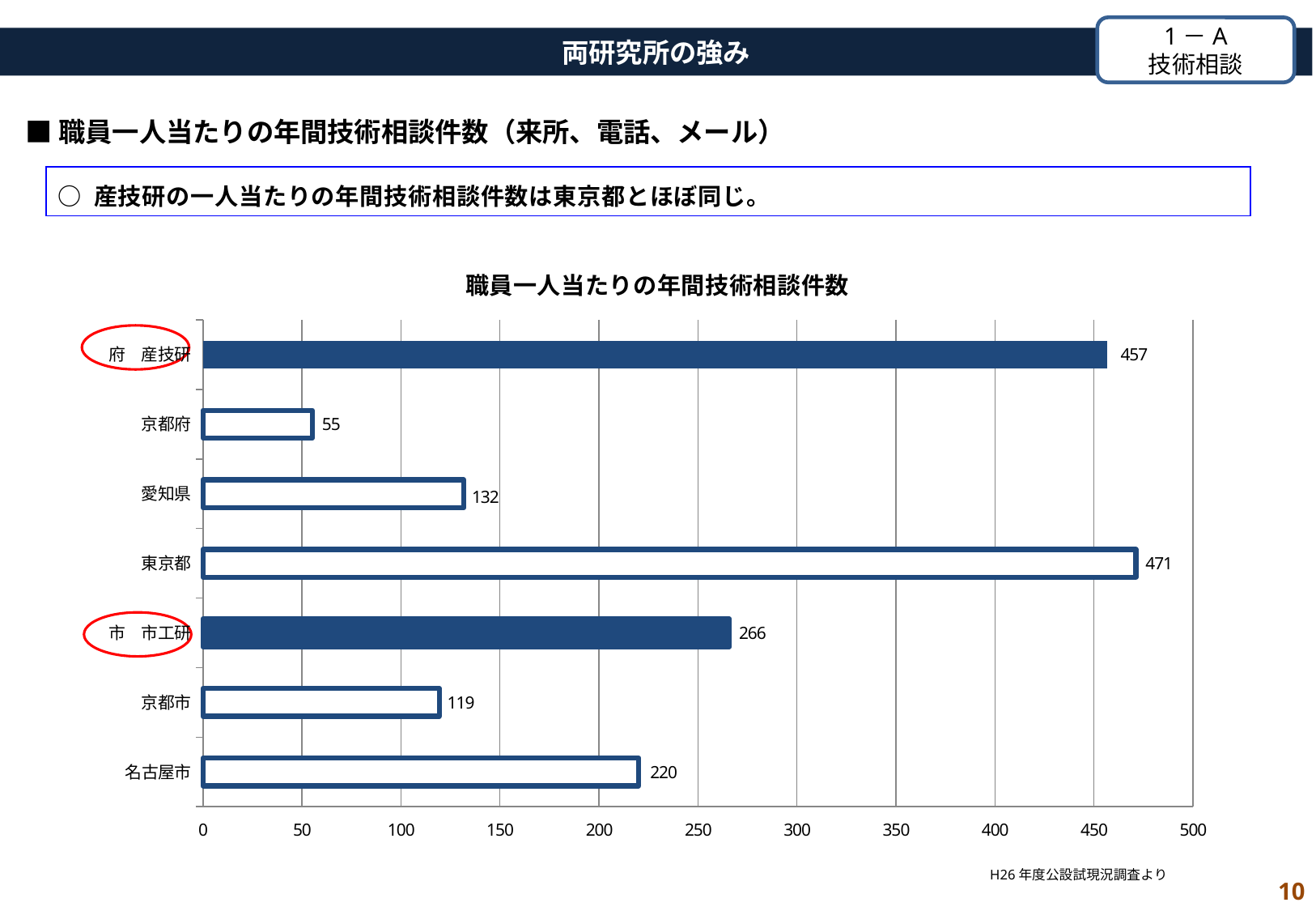
What is the value for 名古屋市 in the chart? 220 Which category has the lowest value in the chart? 京都府 What is the difference between the values for 東京都 and 府 産技研? 14 What is the value for 東京都 in the chart? 471 What is the difference between the values for 市 市工研 and 京都市? 147 What is the title of the chart? 職員一人当たりの年間技術相談件数 How many categories are shown in the chart? 7 What kind of chart is shown on the slide? bar chart Which category has the highest value in the chart? 東京都 Which is larger, the value for 愛知県 or the value for 京都市? 愛知県 What is the value for 府 産技研 in the chart? 457 What is the value for 市 市工研 in the chart? 266